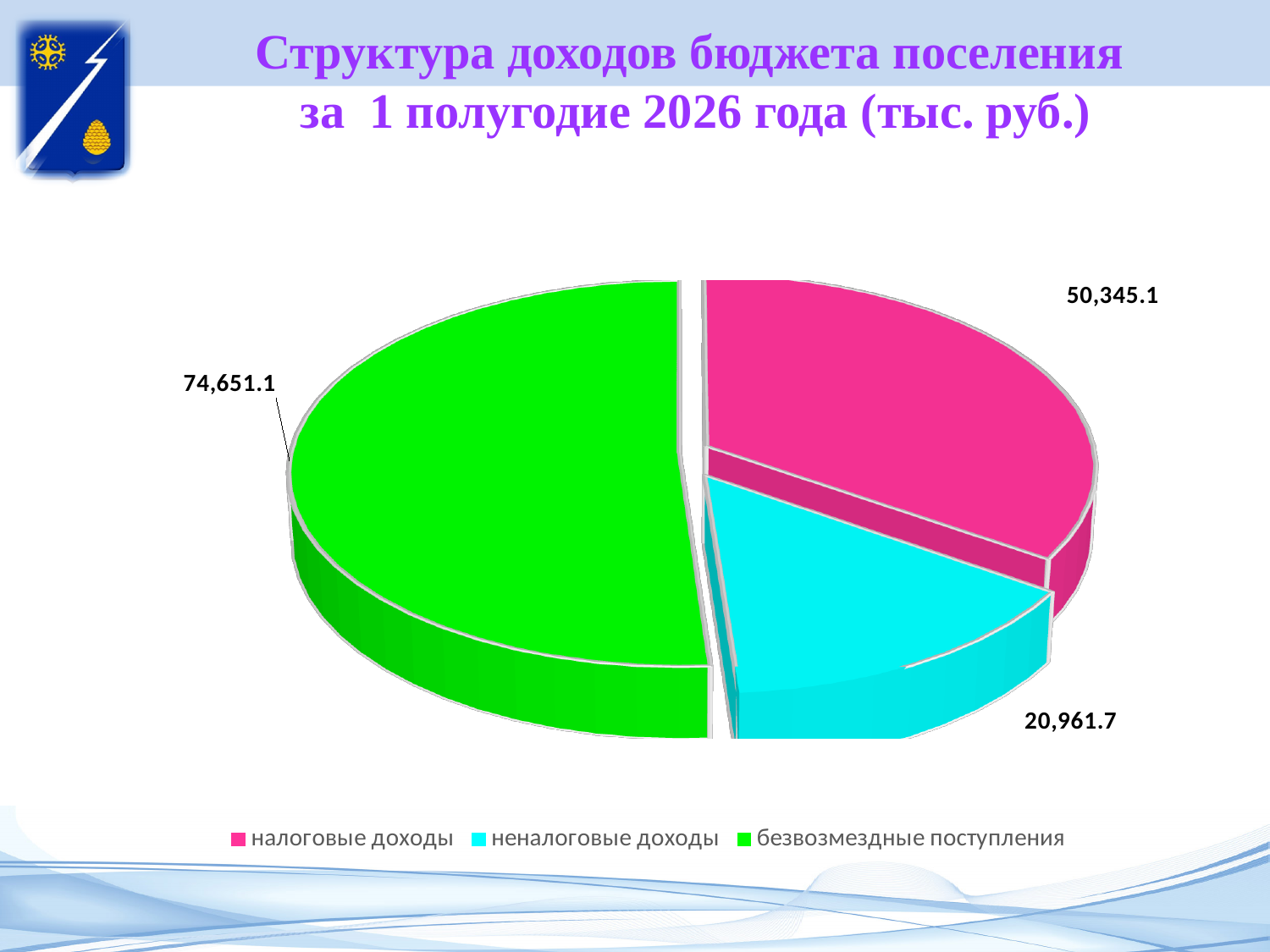
How many slices does the pie chart have? 3 What is the difference between безвозмездные поступления and налоговые доходы? 24,306.0 Which is larger, налоговые доходы or неналоговые доходы? налоговые доходы Which category has the largest value? безвозмездные поступления What colour represents безвозмездные поступления in the legend? Green Which category has the smallest value? неналоговые доходы What is the total of all three slices? 145,957.9 What type of chart is shown on the slide? Pie chart What is the value for безвозмездные поступления? 74,651.1 What is the value for неналоговые доходы? 20,961.7 What is the difference between налоговые доходы and неналоговые доходы? 29,383.4 What is the value for налоговые доходы? 50,345.1